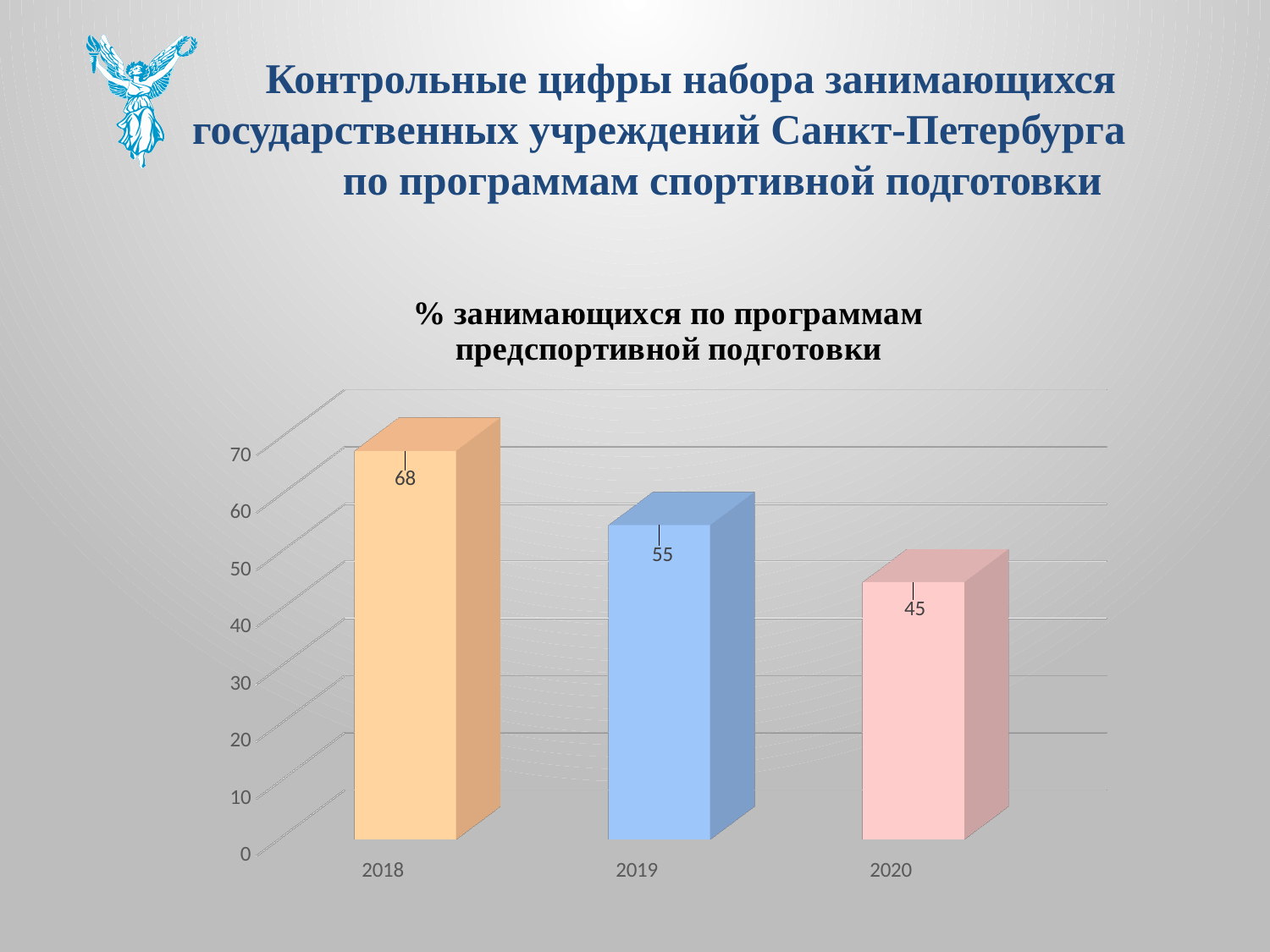
What is the difference between the values for 2018 and 2020? 23 Which year has the highest value? 2018 What kind of chart is shown on the slide? bar chart What is the difference between the values for 2018 and 2019? 13 Is the value for 2019 greater or less than 50? greater What is the value for 2020? 45 Do the values rise or fall from 2018 to 2020? fall How many years are shown on the x axis? 3 Which year has the lowest value? 2020 What is the value for 2018? 68 What is the value for 2019? 55 Which is larger, the value for 2019 or the value for 2020? 2019